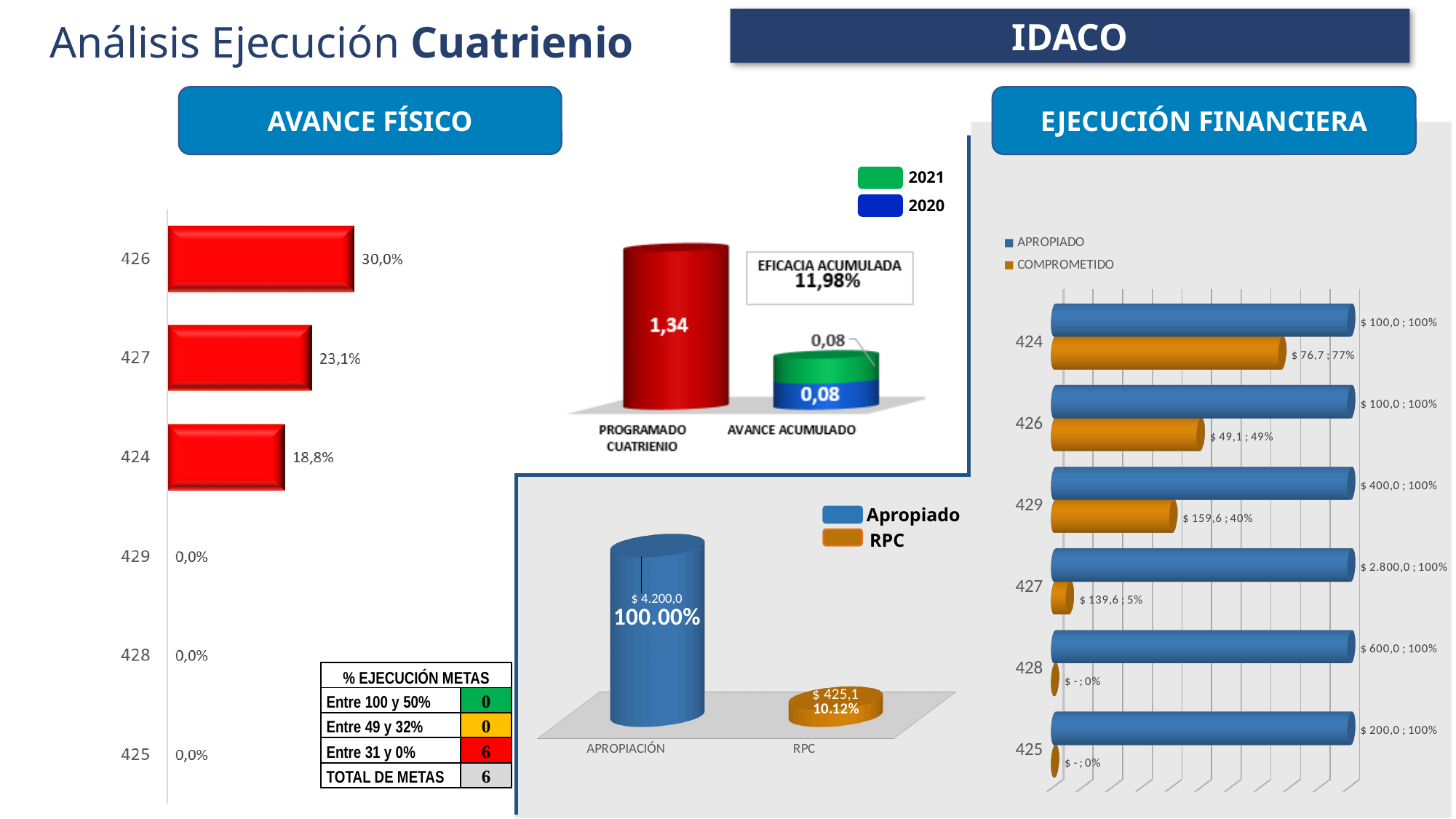
In the AVANCE FÍSICO bar chart on the left, what is the value for category 426? 30,0% In the Apropiado / RPC chart at the bottom middle, what is the value for RPC? $ 425,1 In the AVANCE FÍSICO bar chart on the left, what is the difference between the values for 426 and 427? 6,9% In the AVANCE FÍSICO bar chart on the left, which category has the highest value? 426 In the AVANCE FÍSICO bar chart on the left, what is the value for category 424? 18,8% In the PROGRAMADO CUATRIENIO / AVANCE ACUMULADO chart in the middle, what is the EFICACIA ACUMULADA shown? 11,98% In the EJECUCIÓN FINANCIERA chart on the right, what is the COMPROMETIDO value for category 429? $ 159,6 ; 40% In the EJECUCIÓN FINANCIERA chart on the right, what is the APROPIADO value for category 427? $ 2.800,0 ; 100% In the EJECUCIÓN FINANCIERA chart on the right, how many series does the legend list? 2 In the Apropiado / RPC chart at the bottom middle, what percentage is shown for APROPIACIÓN? 100.00% In the PROGRAMADO CUATRIENIO / AVANCE ACUMULADO chart in the middle, what is the value for PROGRAMADO CUATRIENIO? 1,34 In the AVANCE FÍSICO bar chart on the left, how many categories are shown? 6